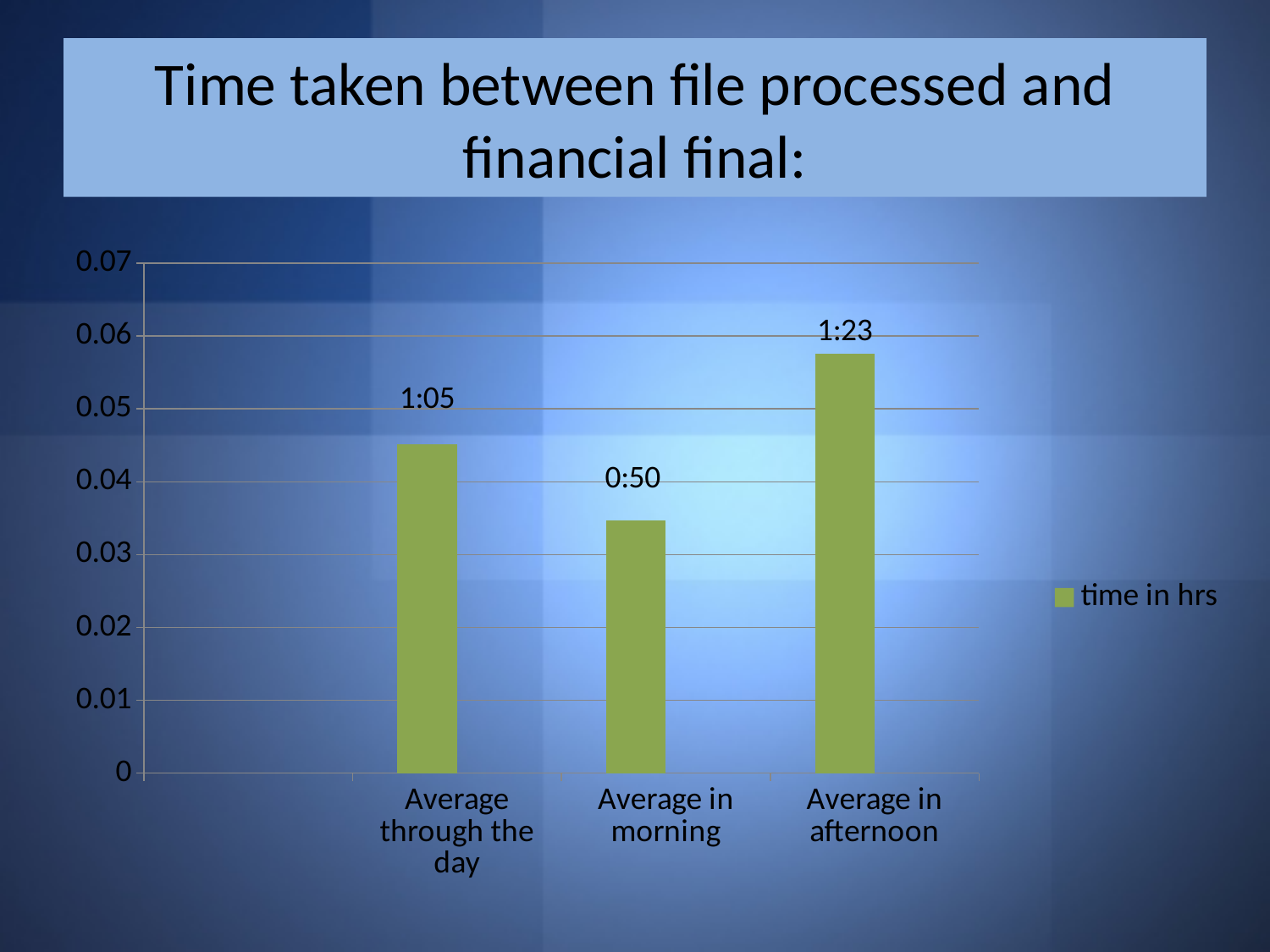
What is the data label shown for Average in morning? 0:50 Is the value for Average through the day greater or less than 0.04 on the axis? greater Which is larger, the value for Average through the day or the value for Average in morning? Average through the day Is the value for Average in morning greater or less than 0.04 on the axis? less What is the data label shown for Average through the day? 1:05 How many categories are shown on the x axis? 3 What kind of chart is shown on the slide? bar chart Which category has the highest bar? Average in afternoon Is the value for Average in afternoon greater or less than 0.05 on the axis? greater What is the data label shown for Average in afternoon? 1:23 What series name does the legend list? time in hrs Which category has the lowest bar? Average in morning